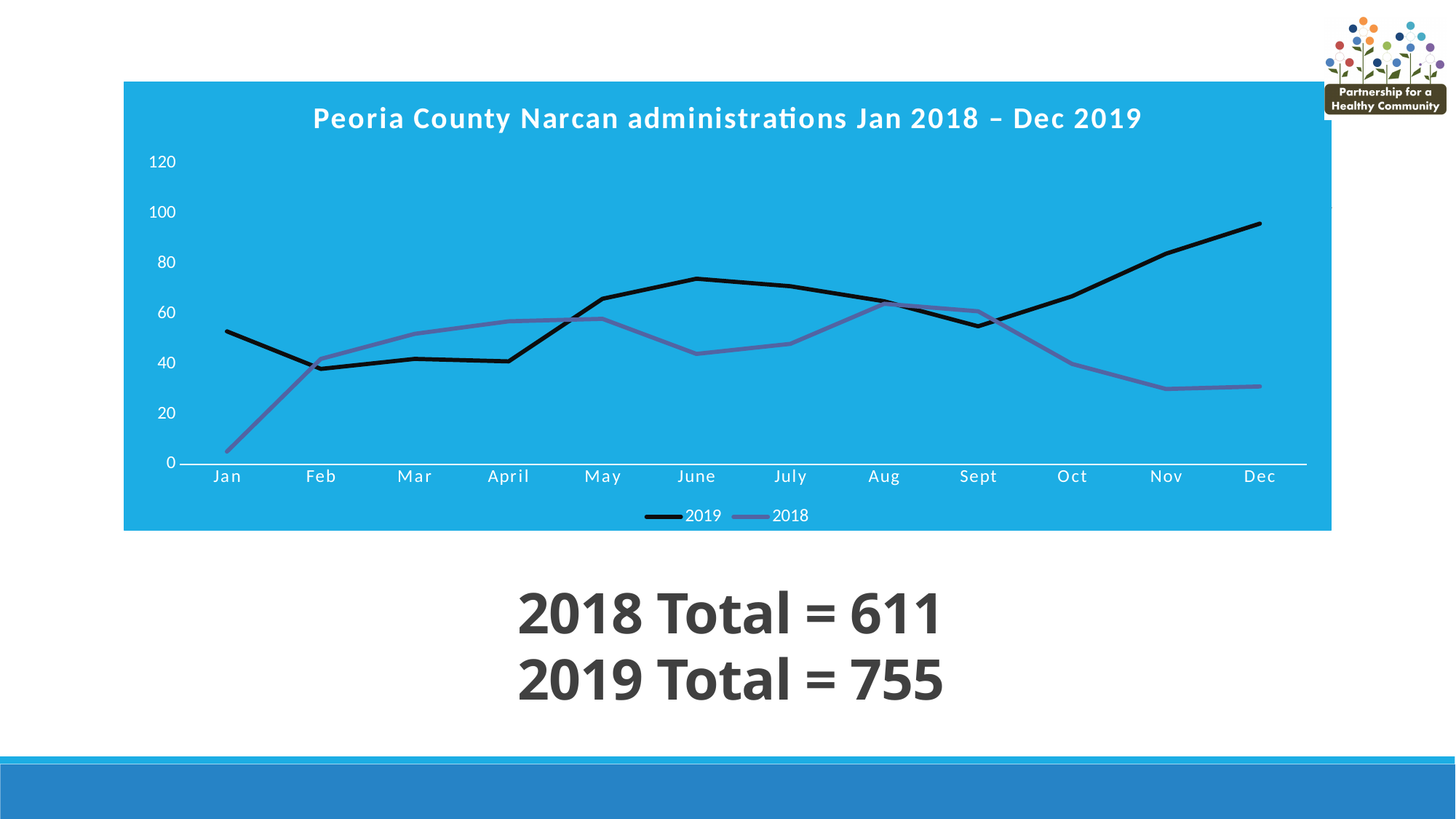
What is the title of the chart? Peoria County Narcan administrations Jan 2018 – Dec 2019 Is the value for 2018 in Jan greater or less than 20? less Is the value for 2018 in Nov greater or less than 40? less In which month does the 2018 line reach its lowest value? Jan How many series does the legend list? 2 Does the 2019 line rise or fall from Sept to Dec? rise In Dec, which series has the larger value, 2019 or 2018? 2019 What kind of chart is shown on the slide? line chart In which month does the 2018 line reach its highest value? Aug How many months are plotted along the x axis? 12 In which month does the 2019 line reach its highest value? Dec Is the value for 2019 in Dec greater or less than 80? greater